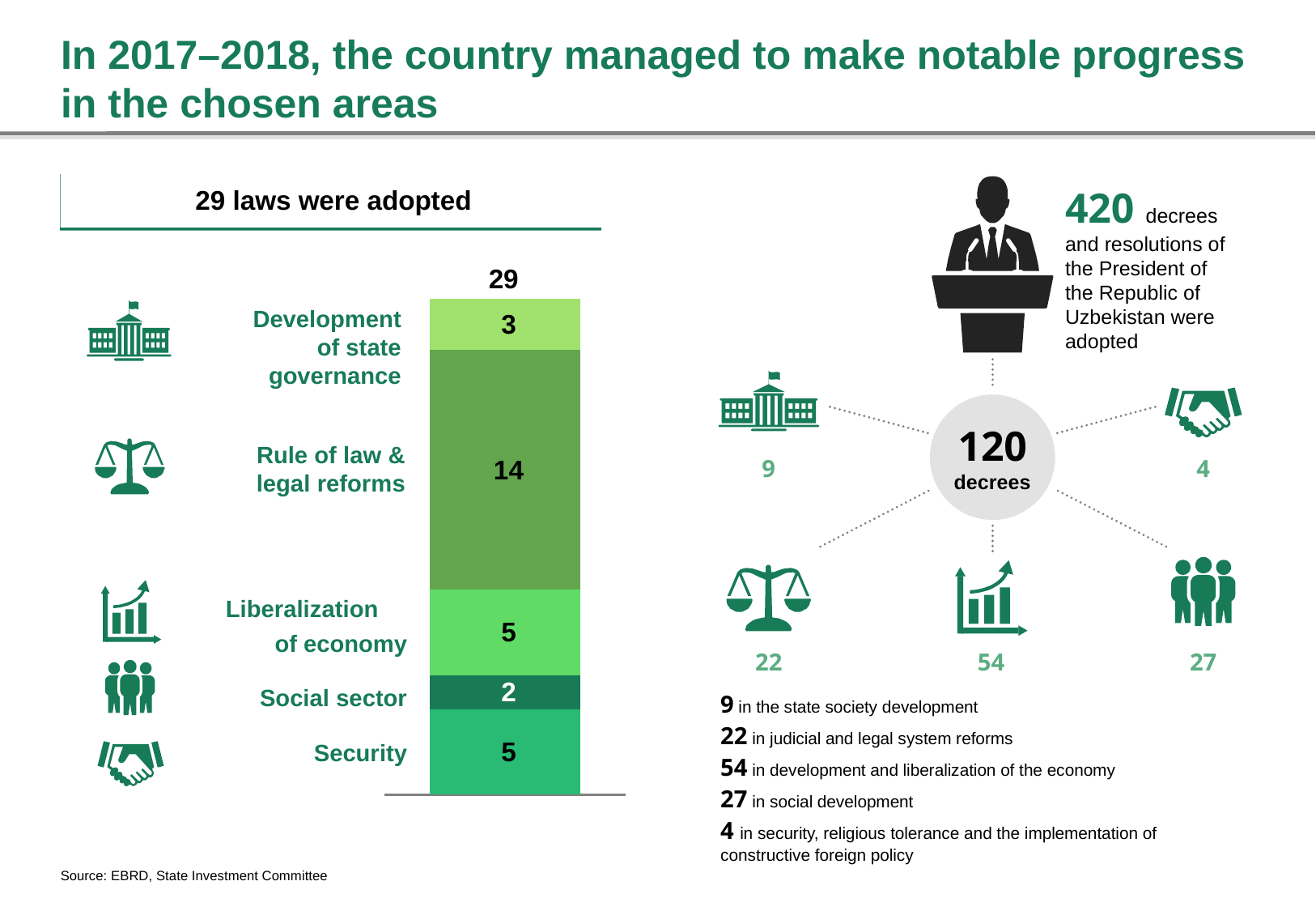
In the '29 laws were adopted' chart, how many laws were adopted for the Social sector? 2 In the '29 laws were adopted' chart, which has more laws adopted: Security or Development of state governance? Security In the '120 decrees' diagram on the right, which area has the fewest decrees? Security, religious tolerance and the implementation of constructive foreign policy In the '29 laws were adopted' chart, how many categories make up the stacked bar? 5 In the '120 decrees' diagram on the right, how many decrees were in development and liberalization of the economy? 54 In the '29 laws were adopted' chart, what is the total of the stacked bar? 29 In the '29 laws were adopted' chart, which category has the largest number of laws adopted? Rule of law & legal reforms What kind of chart is the '29 laws were adopted' chart? Stacked bar chart In the '29 laws were adopted' chart, how many laws were adopted for Rule of law & legal reforms? 14 In the '29 laws were adopted' chart, which category has the smallest number of laws adopted? Social sector In the '29 laws were adopted' chart, what is the difference between the number of laws for Rule of law & legal reforms and for Liberalization of economy? 9 In the '29 laws were adopted' chart, how many laws were adopted for Development of state governance? 3